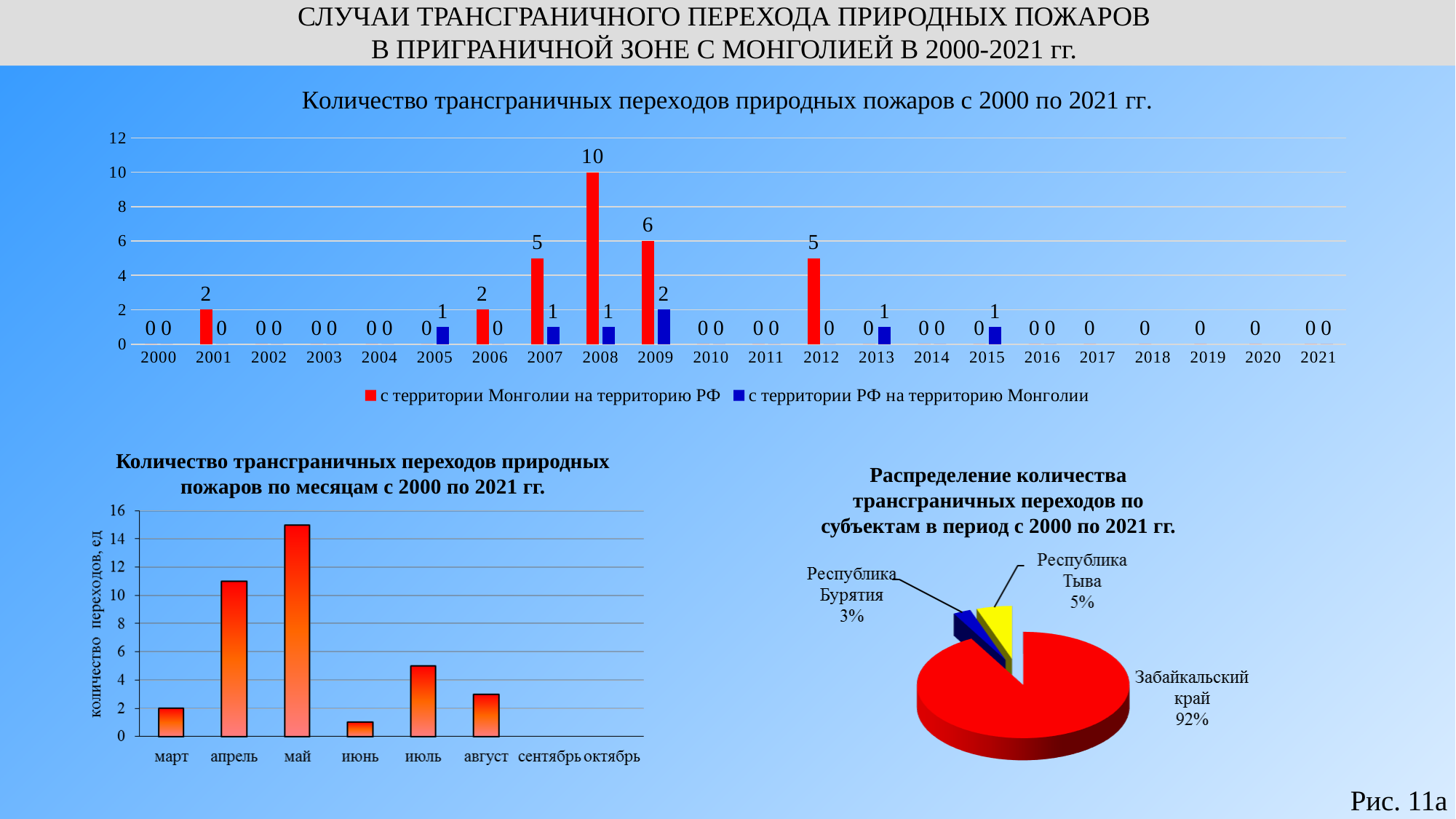
In the top chart, which is larger for 2007: 'с территории Монголии на территорию РФ' or 'с территории РФ на территорию Монголии'? с территории Монголии на территорию РФ In the bottom-left chart, is the value for апрель greater or less than 10? greater In the bottom-left chart, what is the value for март? 2 In the top chart, what is the difference between the 2008 and 2009 values for 'с территории Монголии на территорию РФ'? 4 How many series does the legend of the top chart list? 2 In the top chart, which year has the highest value for 'с территории Монголии на территорию РФ'? 2008 How many years are shown on the x axis of the top chart? 22 In the top chart, what is the value for 2009 for the series 'с территории РФ на территорию Монголии'? 2 What kind of chart is the bottom-right chart 'Распределение количества трансграничных переходов по субъектам'? pie chart In the bottom-left chart 'Количество трансграничных переходов природных пожаров по месяцам', which month has the highest value? май In the top chart 'Количество трансграничных переходов природных пожаров с 2000 по 2021 гг.', what is the value for 2008 for the series 'с территории Монголии на территорию РФ'? 10 In the bottom-right pie chart, what share does Забайкальский край have? 92%